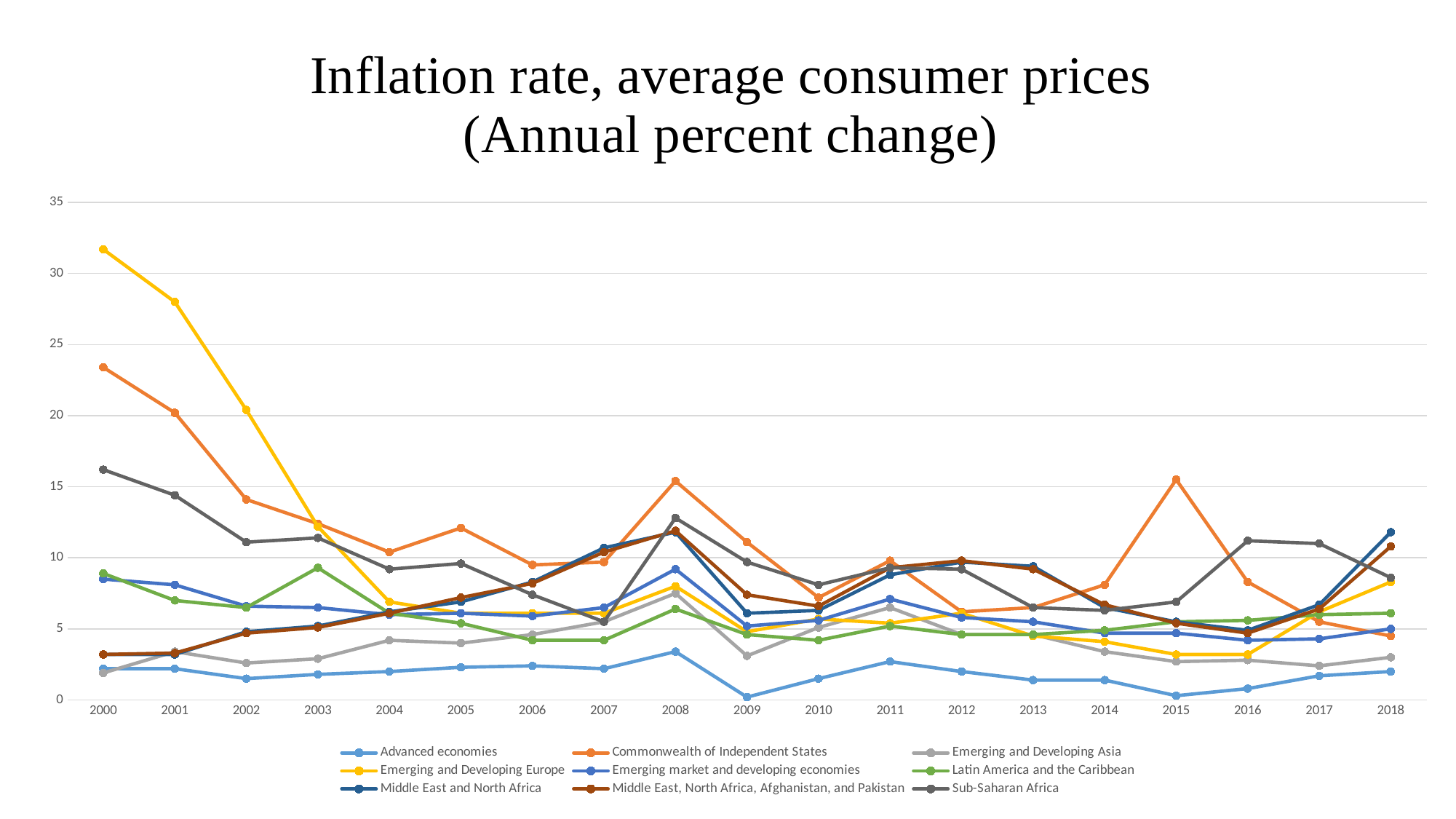
Which series has the highest value in 2015? Commonwealth of Independent States How many years are plotted along the x axis? 19 Is the value for Advanced economies in 2009 greater or less than 5? less Which series has the highest value in 2000? Emerging and Developing Europe Is the value for Sub-Saharan Africa in 2000 greater or less than 15? greater How many series does the legend list? 9 What kind of chart is shown on the slide? line chart Which series has the lowest value in 2015? Advanced economies In 2016, which is larger: Sub-Saharan Africa or Advanced economies? Sub-Saharan Africa Does the Emerging and Developing Europe line rise or fall from 2000 to 2003? fall Is the value for Emerging and Developing Europe in 2000 greater or less than 30? greater